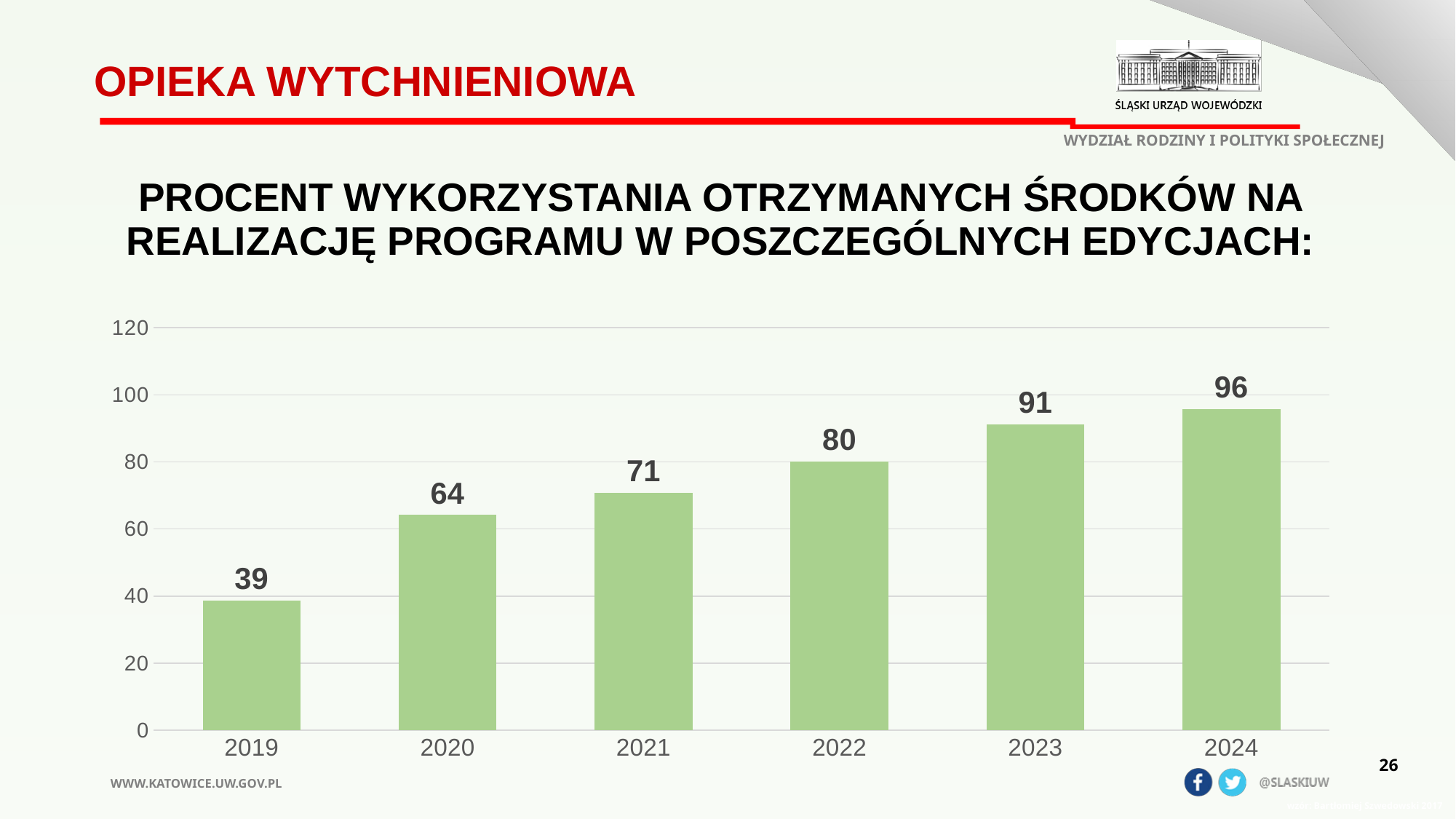
What is the value for 2019? 39 What is the value for 2022? 80 What kind of chart is shown on the slide? bar chart Which year has the highest value? 2024 What is the difference between the values for 2024 and 2019? 57 How many years are shown on the x axis? 6 Which year has the lowest value? 2019 Which is larger, the value for 2023 or the value for 2022? 2023 Is the value for 2020 greater or less than 60? greater What is the value for 2024? 96 Do the values rise or fall from 2019 to 2024? rise What is the difference between the values for 2021 and 2020? 7